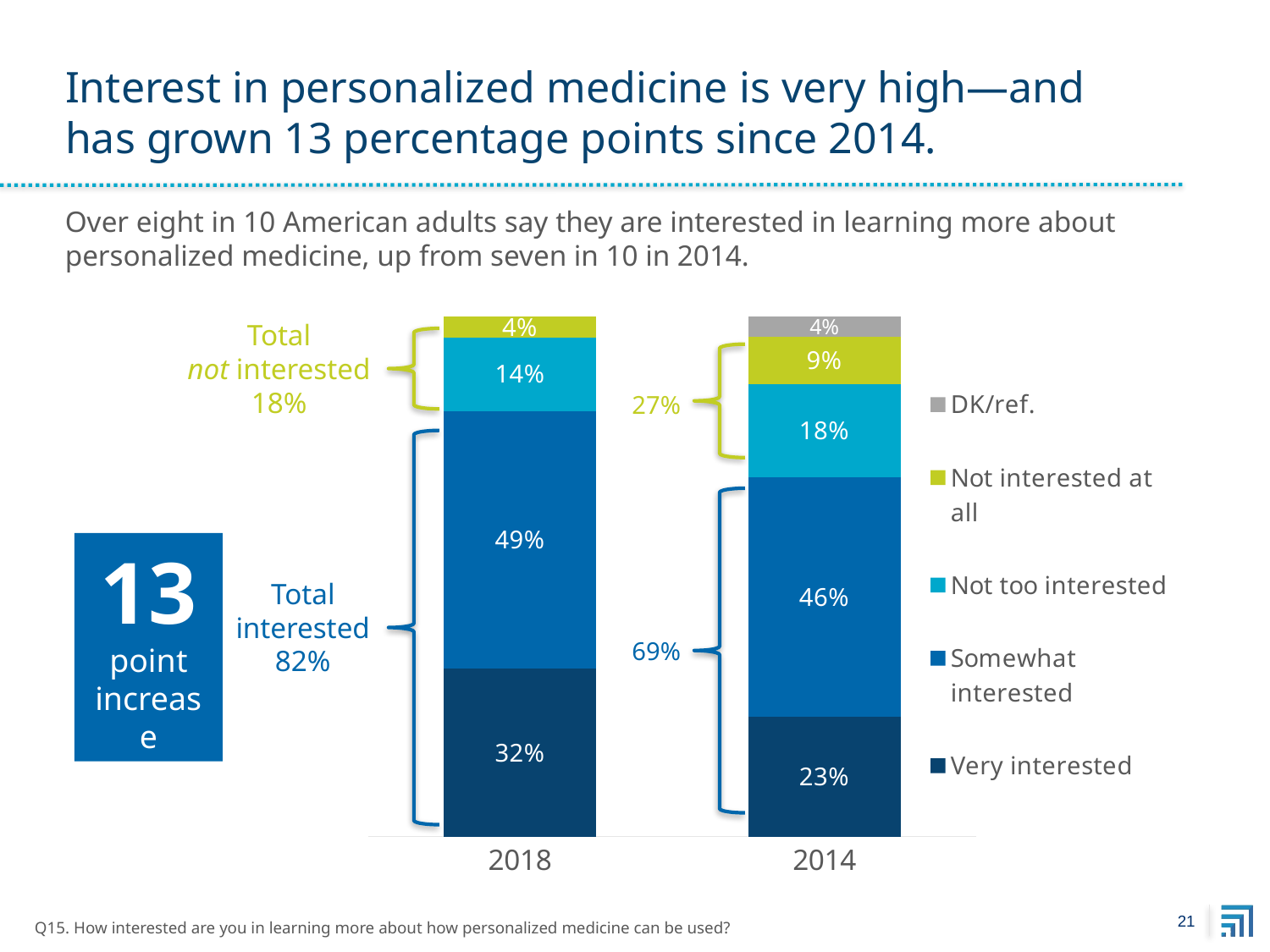
How many years (bars) are shown in the chart? 2 What percentage of respondents were "Very interested" in 2018? 32% Which response category has the largest share in the 2018 bar? Somewhat interested What percentage of respondents were "Not too interested" in 2018? 14% What kind of chart is shown on the slide? Stacked bar chart Which year had a higher share of "Not interested at all" responses, 2018 or 2014? 2014 Which response category has the smallest share in the 2014 bar? DK/ref. By how many percentage points did "Very interested" change from 2014 to 2018? 9 percentage points What percentage of respondents were "Somewhat interested" in 2014? 46% What percentage of respondents answered "DK/ref." in 2014? 4% How many series does the legend list? 5 What is the total of all segments in the 2014 bar? 100%